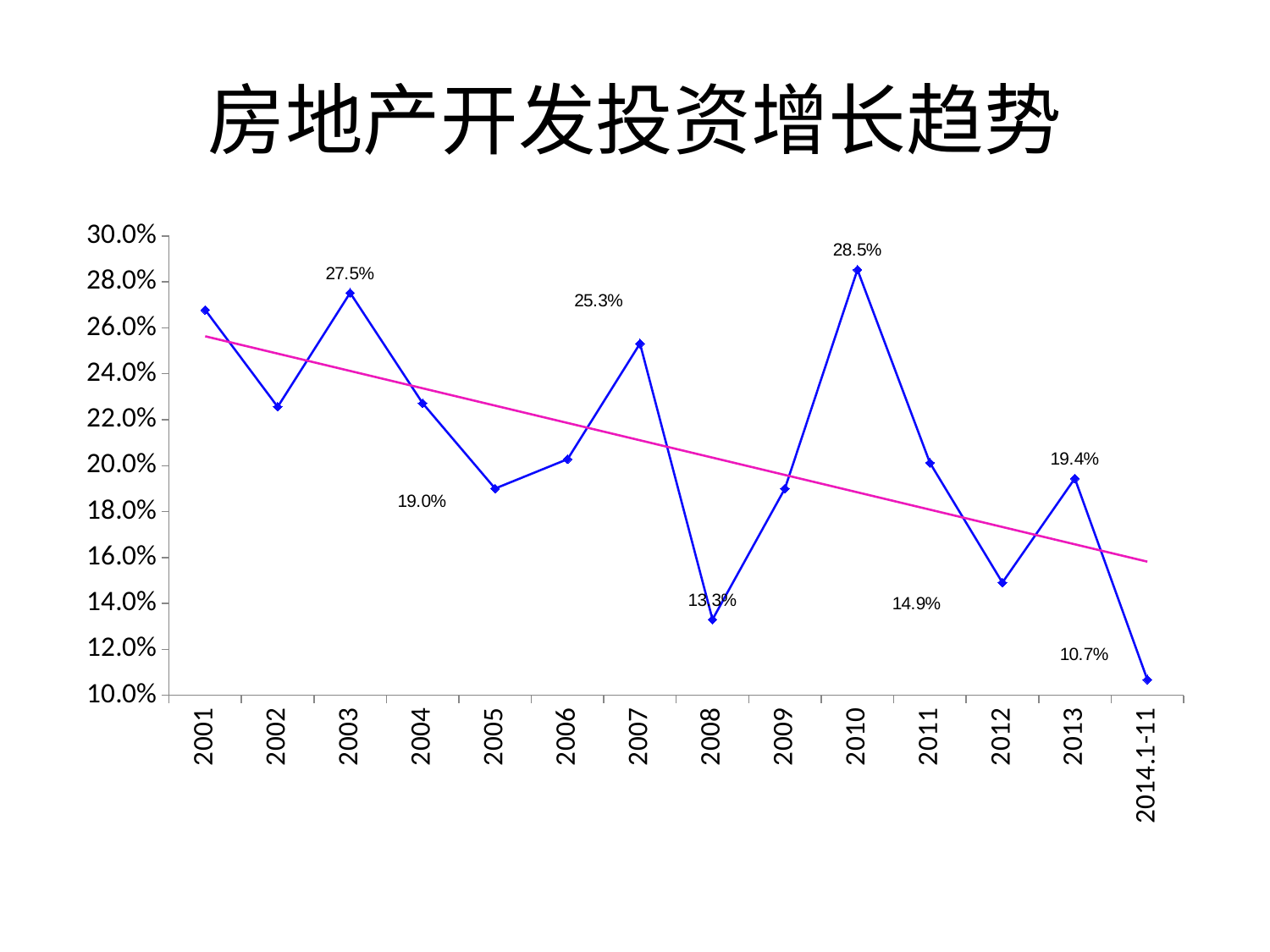
What is the difference between the values for 2013 and 2012? 4.5 percentage points How many categories are shown on the x axis? 14 What is the difference between the values for 2010 and 2014.1-11? 17.8 percentage points Is the value for 2001 greater or less than 26.0%? greater Which is larger, the value for 2003 or the value for 2007? 2003 What is the value for 2014.1-11? 10.7% What is the value for 2003? 27.5% What is the value for 2008? 13.3% What is the value for 2010? 28.5% Which category has the lowest value? 2014.1-11 Which year has the highest value? 2010 Is the value for 2002 greater or less than 24.0%? less